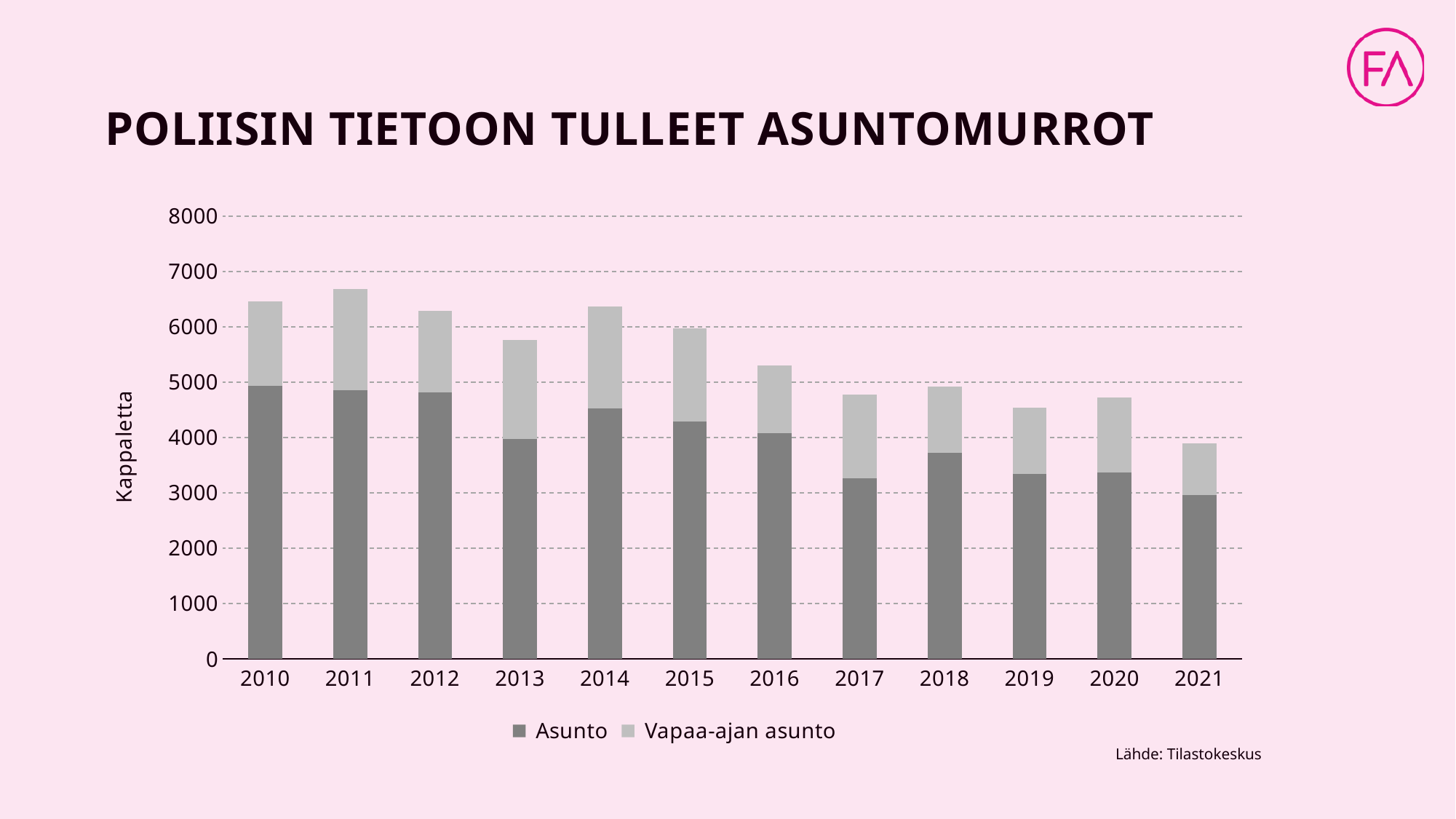
Is the total value for 2011 greater or less than 6000? greater Do the total values generally rise or fall from 2010 to 2021? fall Is the Asunto value for 2017 greater or less than 4000? less Is the total value for 2021 greater or less than 5000? less What kind of chart is shown on the slide? Stacked bar chart Which year has the lowest total number of burglaries in the chart? 2021 How many series does the chart's legend list? 2 How many years are shown on the x axis of the chart? 12 Which year has the lowest value for the Asunto series? 2021 What is the label on the vertical axis of the chart? Kappaletta Which year has the highest total number of burglaries in the chart? 2011